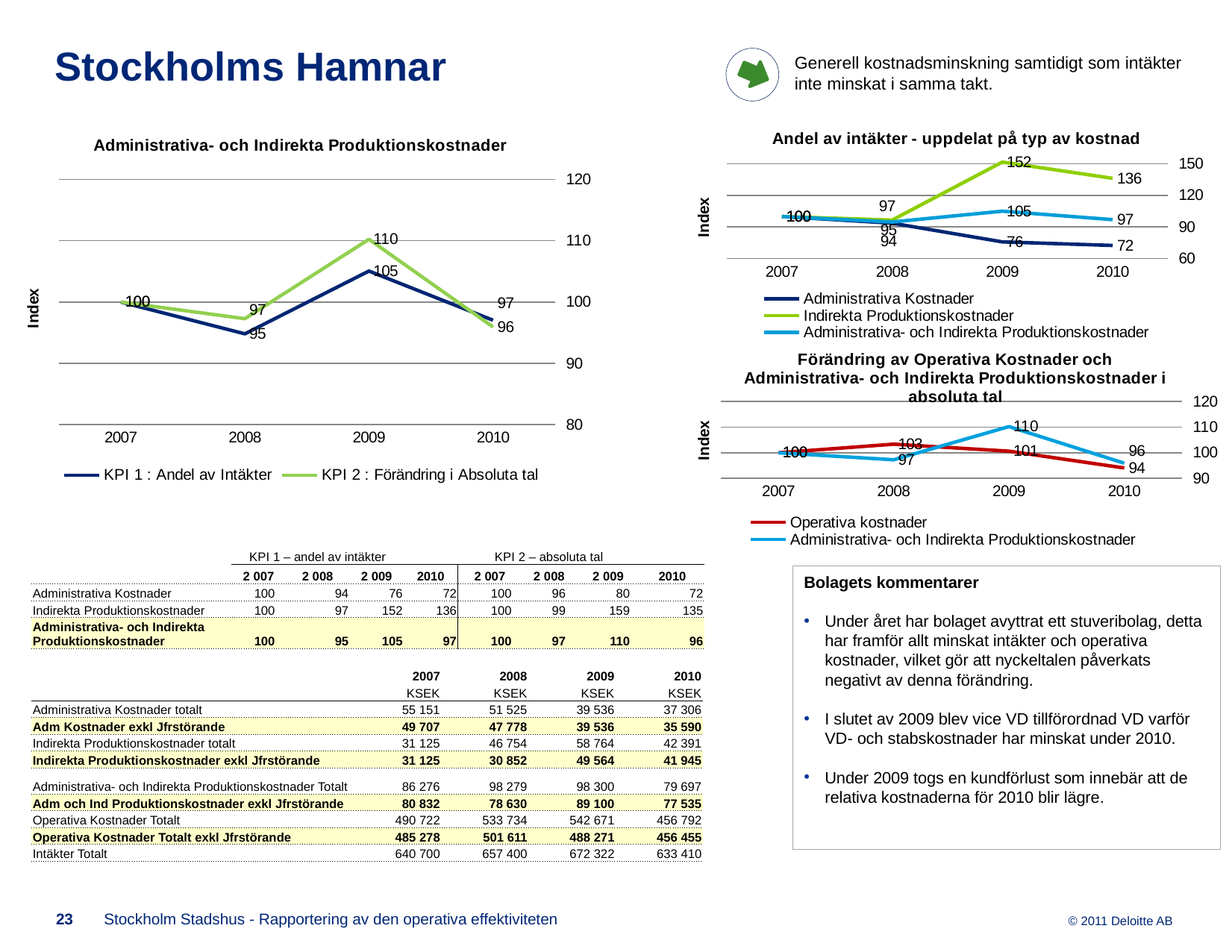
In the chart titled 'Andel av intäkter - uppdelat på typ av kostnad', what is the value of Indirekta Produktionskostnader in 2009? 152 In the chart titled 'Administrativa- och Indirekta Produktionskostnader', what is the value of KPI 1 : Andel av Intäkter in 2008? 95 In the bottom-right chart 'Förändring av Operativa Kostnader och Administrativa- och Indirekta Produktionskostnader i absoluta tal', what is the value of Operativa kostnader in 2008? 103 In the chart titled 'Andel av intäkter - uppdelat på typ av kostnad', does Administrativa Kostnader rise or fall from 2007 to 2010? fall In the chart titled 'Andel av intäkter - uppdelat på typ av kostnad', how many series does the legend list? 3 In the chart titled 'Administrativa- och Indirekta Produktionskostnader', in which year is KPI 1 : Andel av Intäkter highest? 2009 In the chart titled 'Administrativa- och Indirekta Produktionskostnader', how many series does the legend list? 2 In the chart titled 'Administrativa- och Indirekta Produktionskostnader', what is the difference between KPI 2 and KPI 1 in 2009? 5 In the chart titled 'Administrativa- och Indirekta Produktionskostnader', what is the value of KPI 2 : Förändring i Absoluta tal in 2009? 110 In the chart titled 'Andel av intäkter - uppdelat på typ av kostnad', what is the value of Administrativa Kostnader in 2010? 72 In the chart titled 'Andel av intäkter - uppdelat på typ av kostnad', which series has the lowest value in 2010? Administrativa Kostnader In the bottom-right chart 'Förändring av Operativa Kostnader och Administrativa- och Indirekta Produktionskostnader i absoluta tal', which series has the higher value in 2009? Administrativa- och Indirekta Produktionskostnader